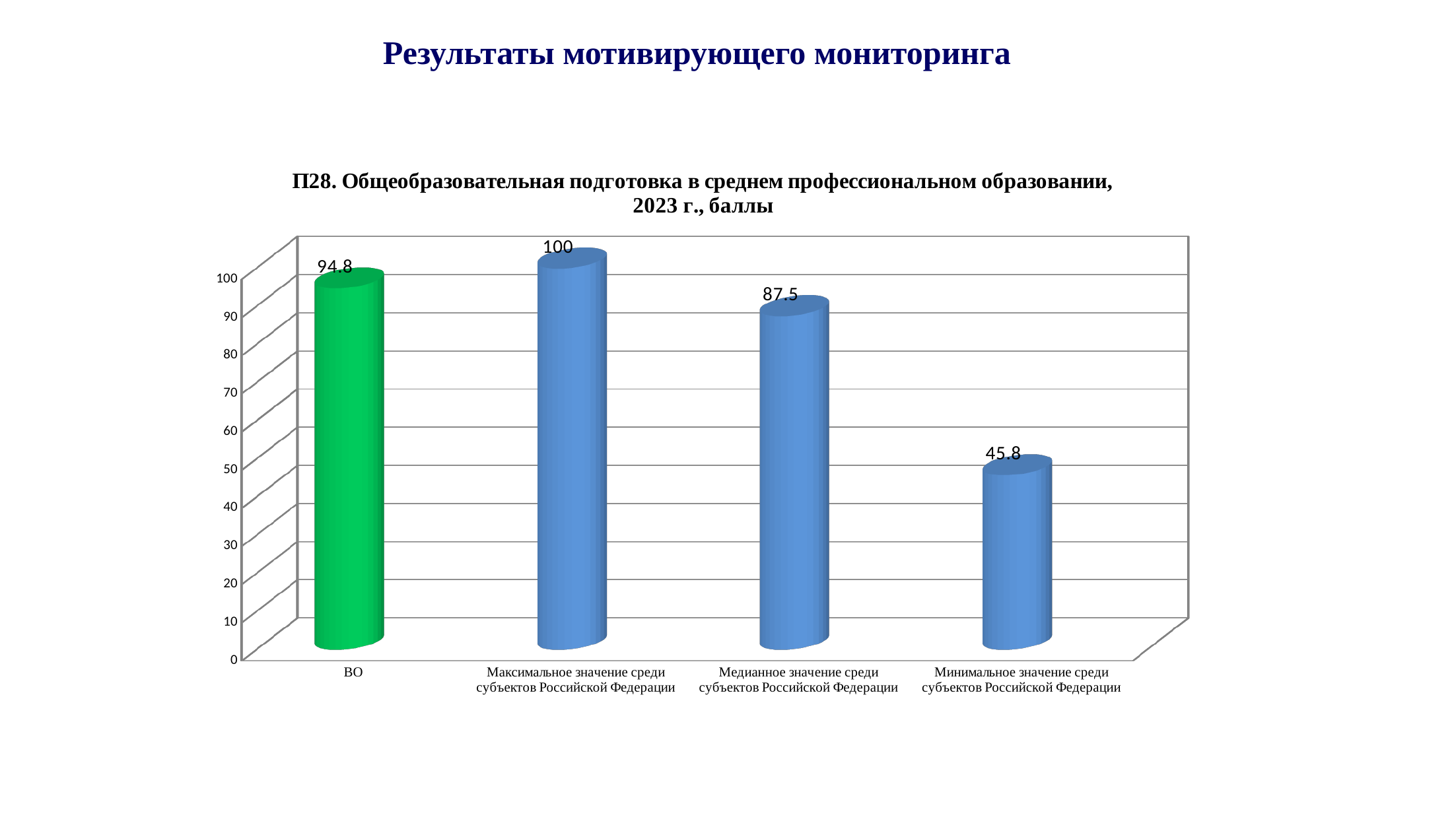
What is the value for Минимальное значение среди субъектов Российской Федерации? 45.8 How many categories are shown in the chart? 4 What is the difference between the value for ВО and the Медианное значение среди субъектов Российской Федерации? 7.3 What is the title of the chart? П28. Общеобразовательная подготовка в среднем профессиональном образовании, 2023 г., баллы Which category has the lowest value? Минимальное значение среди субъектов Российской Федерации What is the difference between the Максимальное значение and the Минимальное значение среди субъектов Российской Федерации? 54.2 Which category has the highest value? Максимальное значение среди субъектов Российской Федерации What kind of chart is shown on the slide? Bar chart Which is larger: the value for ВО or the Медианное значение среди субъектов Российской Федерации? ВО What is the value for Медианное значение среди субъектов Российской Федерации? 87.5 What is the value for ВО? 94.8 What is the value for Максимальное значение среди субъектов Российской Федерации? 100